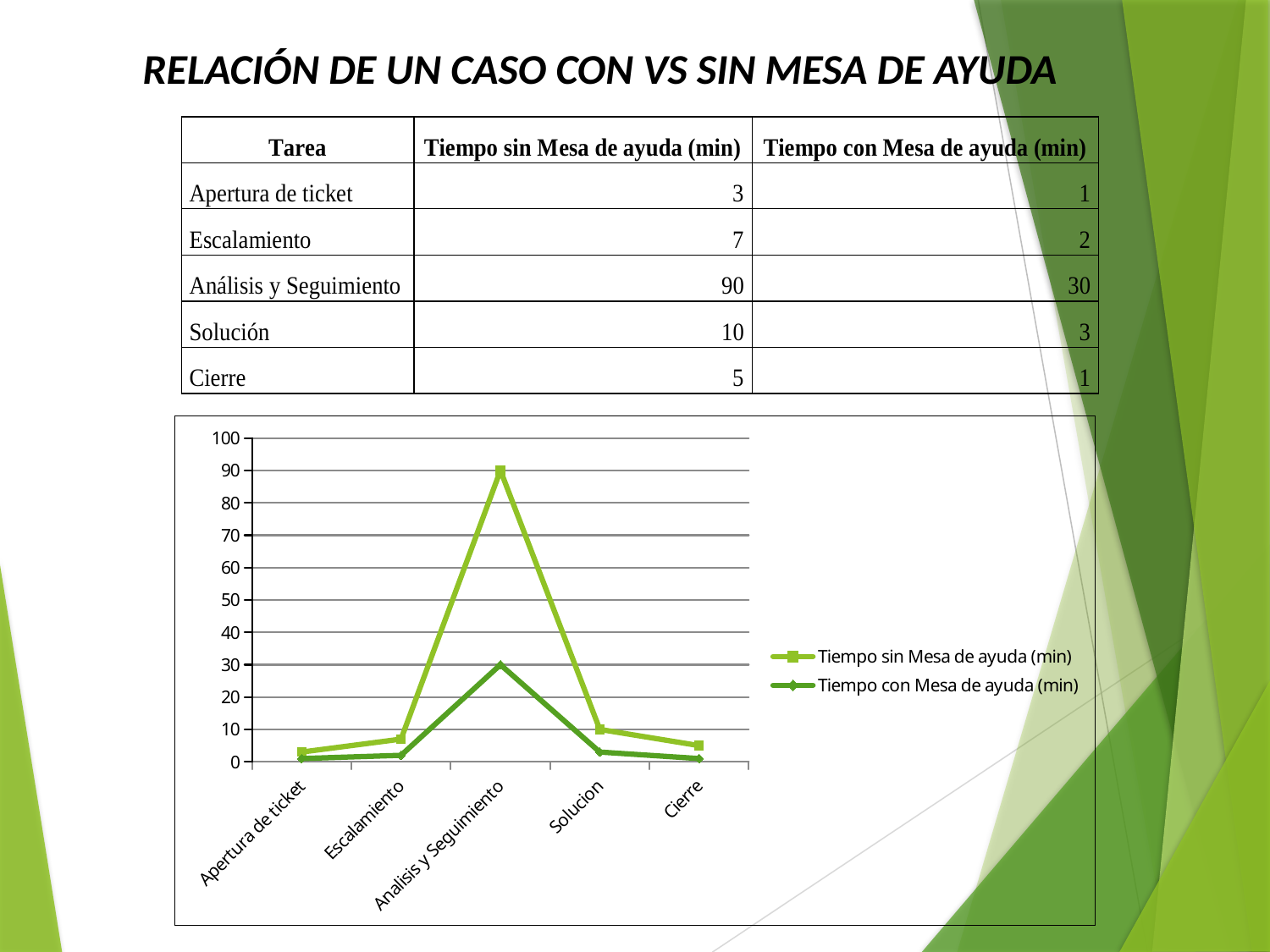
What is the highest tick value shown on the y axis of the chart? 100 Is the value for 'Analisis y Seguimiento' in the series 'Tiempo con Mesa de ayuda (min)' greater or less than 40? less How many categories are plotted along the x axis of the chart? 5 How many series does the chart legend list? 2 What is the value for 'Analisis y Seguimiento' in the series 'Tiempo con Mesa de ayuda (min)'? 30 What kind of chart is shown on the slide? line chart What is the difference between the 'Tiempo sin Mesa de ayuda (min)' and 'Tiempo con Mesa de ayuda (min)' values for 'Analisis y Seguimiento'? 60 Is the value for 'Analisis y Seguimiento' in the series 'Tiempo sin Mesa de ayuda (min)' greater or less than 80? greater Which is larger for 'Escalamiento': the 'Tiempo sin Mesa de ayuda (min)' value or the 'Tiempo con Mesa de ayuda (min)' value? Tiempo sin Mesa de ayuda (min) Which category has the highest value for the series 'Tiempo sin Mesa de ayuda (min)'? Analisis y Seguimiento What is the value for 'Solucion' in the series 'Tiempo sin Mesa de ayuda (min)'? 10 What is the value for 'Analisis y Seguimiento' in the series 'Tiempo sin Mesa de ayuda (min)'? 90